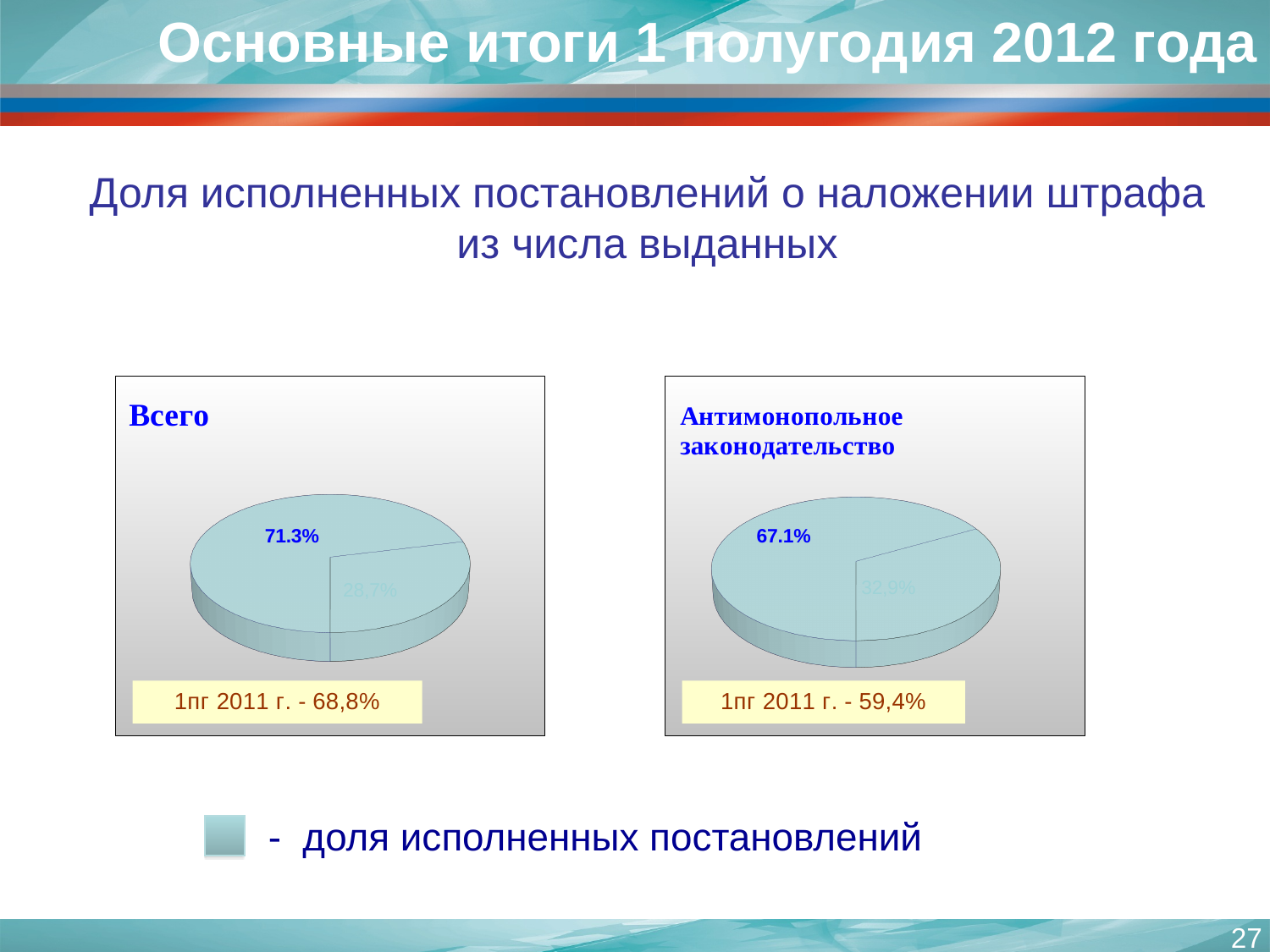
According to the note under the "Антимонопольное законодательство" chart, what was the value for 1пг 2011 г.? 59,4% What kind of chart is shown in the left panel titled "Всего"? Pie chart What is the title of the right-hand pie chart? Антимонопольное законодательство In the "Антимонопольное законодательство" pie chart, what share is labelled for the executed decisions? 67.1% Is the executed-decisions share in the "Антимонопольное законодательство" chart greater or less than 50%? greater What does the legend at the bottom of the slide say the light blue colour represents? доля исполненных постановлений According to the note under the "Всего" chart, what was the value for 1пг 2011 г.? 68,8% How many slices does the "Всего" pie chart have? 2 What is the difference between the executed-decisions share in the "Всего" chart (71.3%) and in the "Антимонопольное законодательство" chart (67.1%)? 4.2 percentage points How many slices does the "Антимонопольное законодательство" pie chart have? 2 Which chart shows the larger share of executed decisions, "Всего" or "Антимонопольное законодательство"? Всего In the "Всего" pie chart, what share of the pie is labelled for the executed decisions (доля исполненных постановлений)? 71.3%